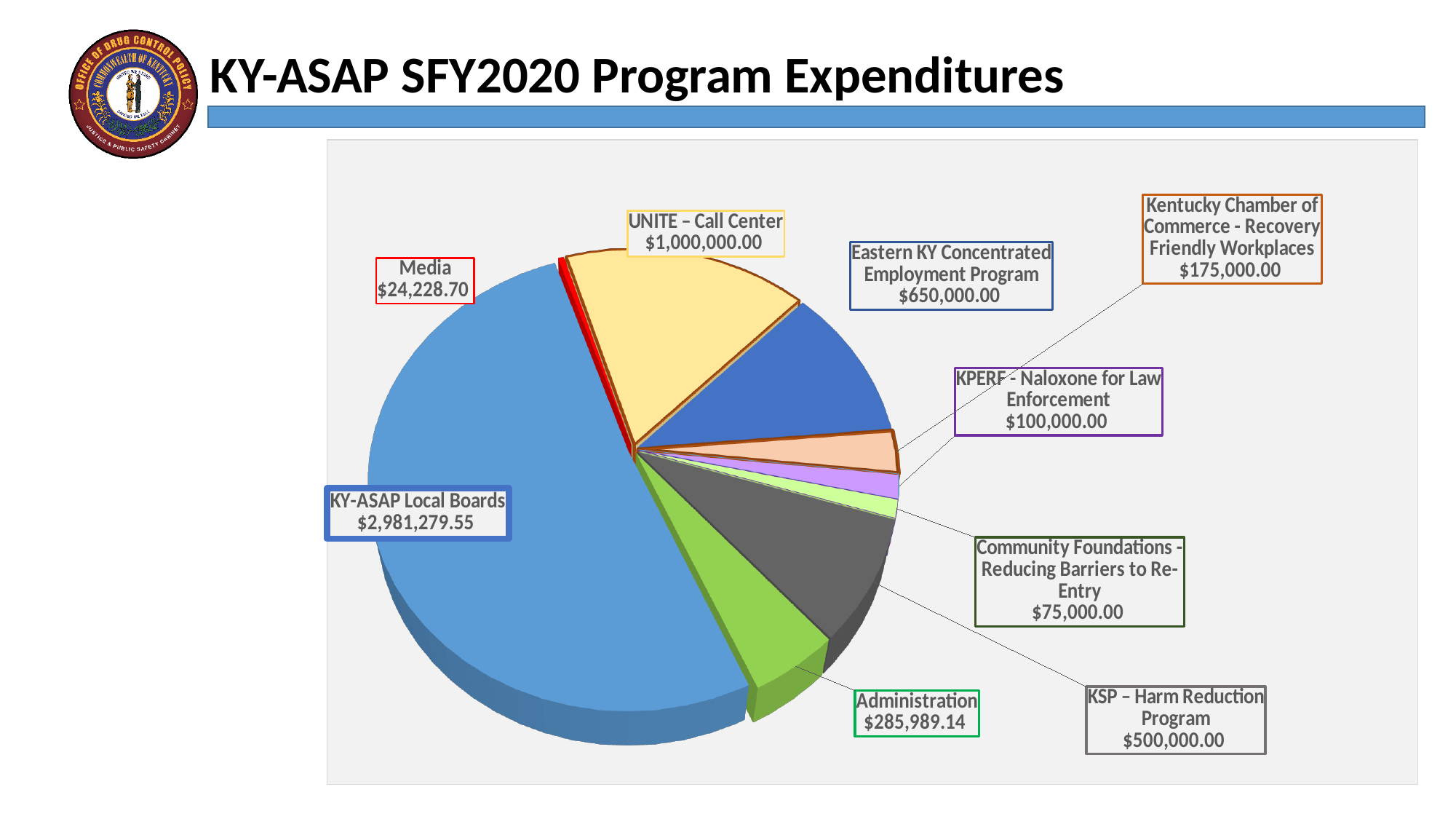
What is the expenditure for Media? $24,228.70 Which is larger, the expenditure for KSP – Harm Reduction Program or for Administration? KSP – Harm Reduction Program Which program has the largest expenditure? KY-ASAP Local Boards What is the difference between the UNITE – Call Center expenditure and the Eastern KY Concentrated Employment Program expenditure? $350,000.00 How many program categories are shown in the pie chart? 9 What is the expenditure for KSP – Harm Reduction Program? $500,000.00 What is the difference between the Kentucky Chamber of Commerce - Recovery Friendly Workplaces expenditure and the KPERF - Naloxone for Law Enforcement expenditure? $75,000.00 What is the expenditure for Administration? $285,989.14 What is the expenditure for UNITE – Call Center? $1,000,000.00 What is the title of the slide? KY-ASAP SFY2020 Program Expenditures Which program has the smallest expenditure? Media What kind of chart is shown on the slide? Pie chart